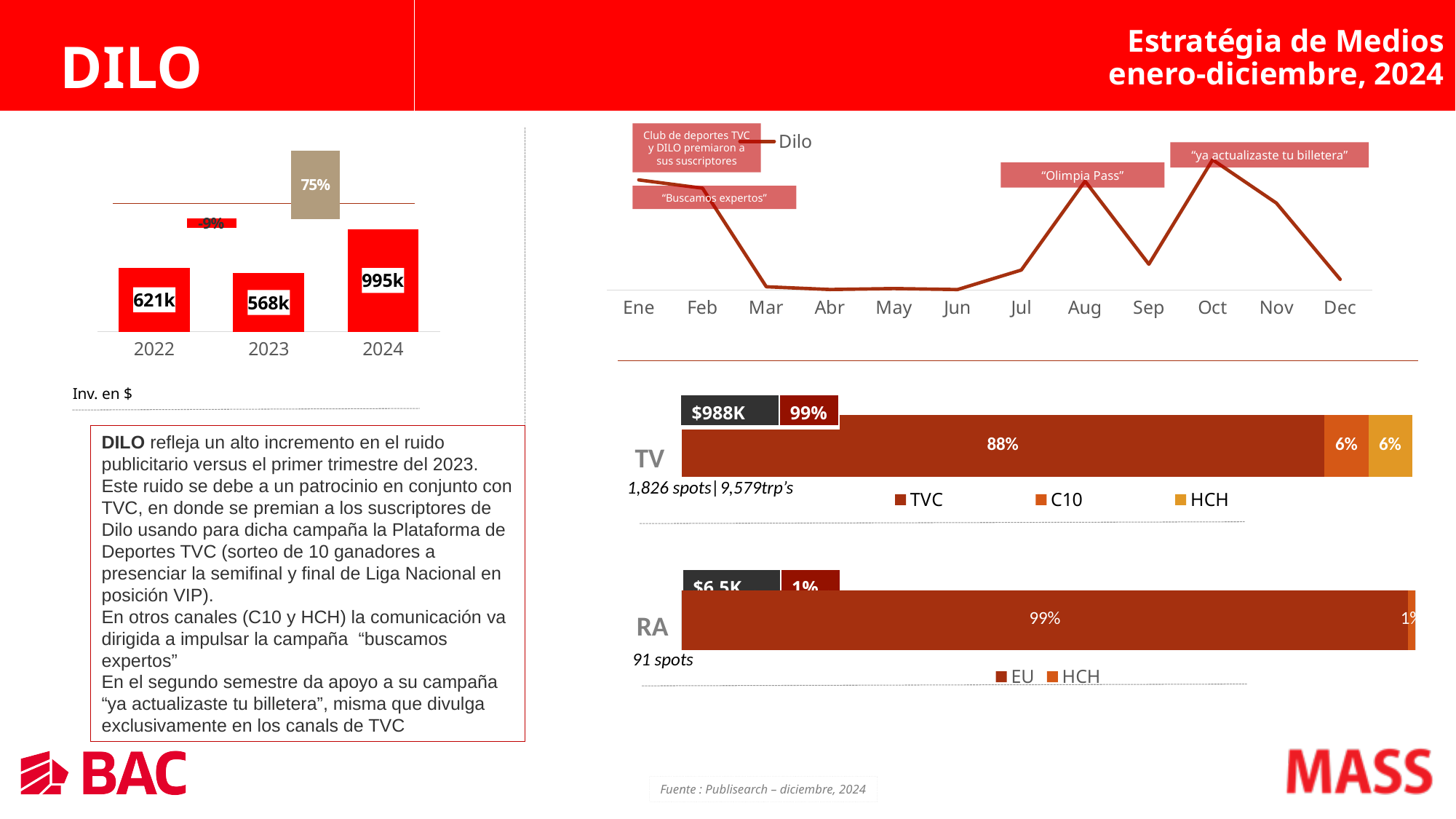
In the bar chart on the left (Inv. en $), which year has the lowest value? 2023 In the bar chart on the left (Inv. en $), what is the value for 2022? 621k In the TV stacked bar, what share does TVC have? 88% In the TV stacked bar, how many series does the legend list? 3 In the bar chart on the left (Inv. en $), what is the value for 2024? 995k In the bar chart on the left (Inv. en $), what percentage change is shown between 2022 and 2023? -9% In the Dilo line chart at the top right, how many months are shown on the x axis? 12 What kind of chart is the Dilo chart at the top right with months Ene to Dec? line chart In the bar chart on the left (Inv. en $), what percentage change is shown between 2023 and 2024? 75% In the RA stacked bar, what share does EU have? 99% In the bar chart on the left (Inv. en $), how many years are shown? 3 In the bar chart on the left (Inv. en $), which year has the highest value? 2024